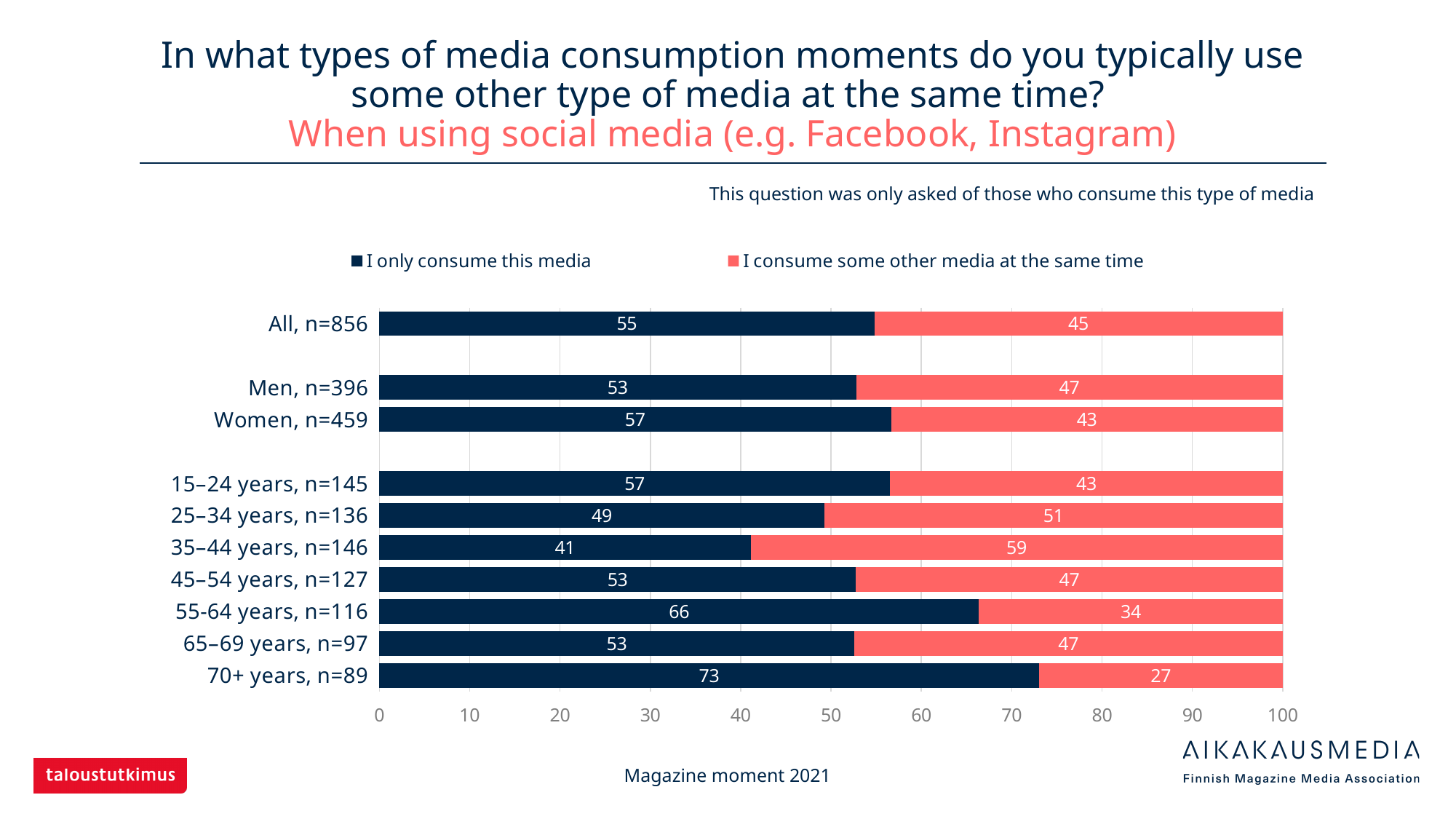
What is the total of the stacked bar for 25–34 years, n=136? 100 What is the value of "I only consume this media" for All, n=856? 55 Which category has the lowest value for "I only consume this media"? 35–44 years, n=146 What is the value of "I consume some other media at the same time" for 35–44 years, n=146? 59 Which is larger: the "I consume some other media at the same time" value for Men, n=396 or for Women, n=459? Men, n=396 What colour represents "I consume some other media at the same time" in the chart? Red (coral) What is the difference between the "I only consume this media" values for 70+ years, n=89 and 55-64 years, n=116? 7 How many series does the legend list? 2 Which category has the highest value for "I only consume this media"? 70+ years, n=89 What is the value of "I only consume this media" for Women, n=459? 57 How many categories are shown on the y axis of the chart? 10 What kind of chart is shown on the slide? Stacked bar chart